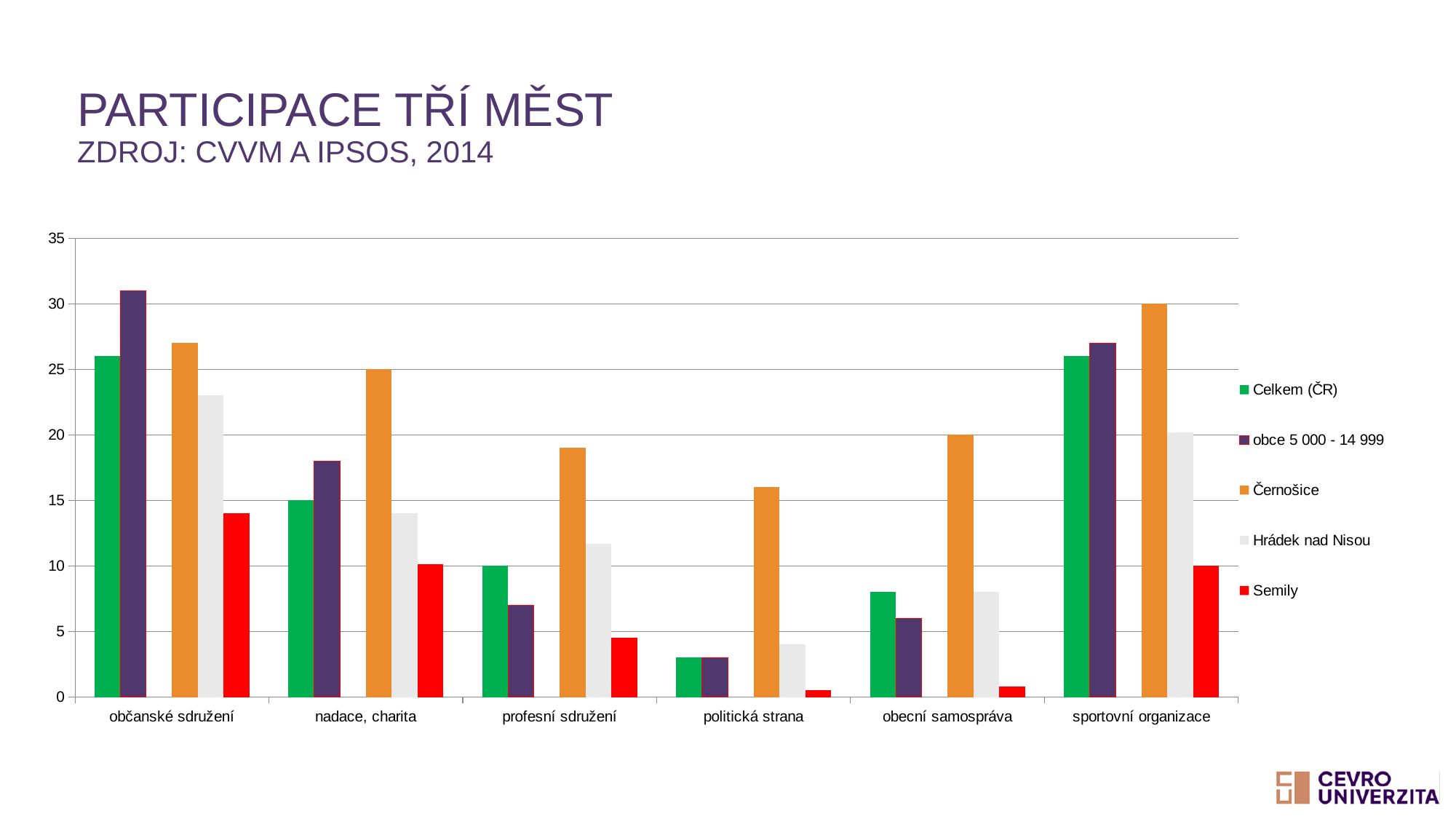
What is the value for Černošice in the category obecní samospráva? 20 How many categories are shown on the x axis? 6 In which category does Černošice have its highest value? sportovní organizace In which category does Semily have its lowest value? politická strana How many series does the legend list? 5 What is the value for Celkem (ČR) in the category nadace, charita? 15 In the category nadace, charita, which is larger: Celkem (ČR) or obce 5 000 - 14 999? obce 5 000 - 14 999 Which series has the highest value in the category občanské sdružení? obce 5 000 - 14 999 What is the source given in the slide subtitle? CVVM a IPSOS, 2014 What is the value for Černošice in the category sportovní organizace? 30 What kind of chart is shown on the slide? bar chart Is the value for Hrádek nad Nisou in občanské sdružení greater or less than 25? less